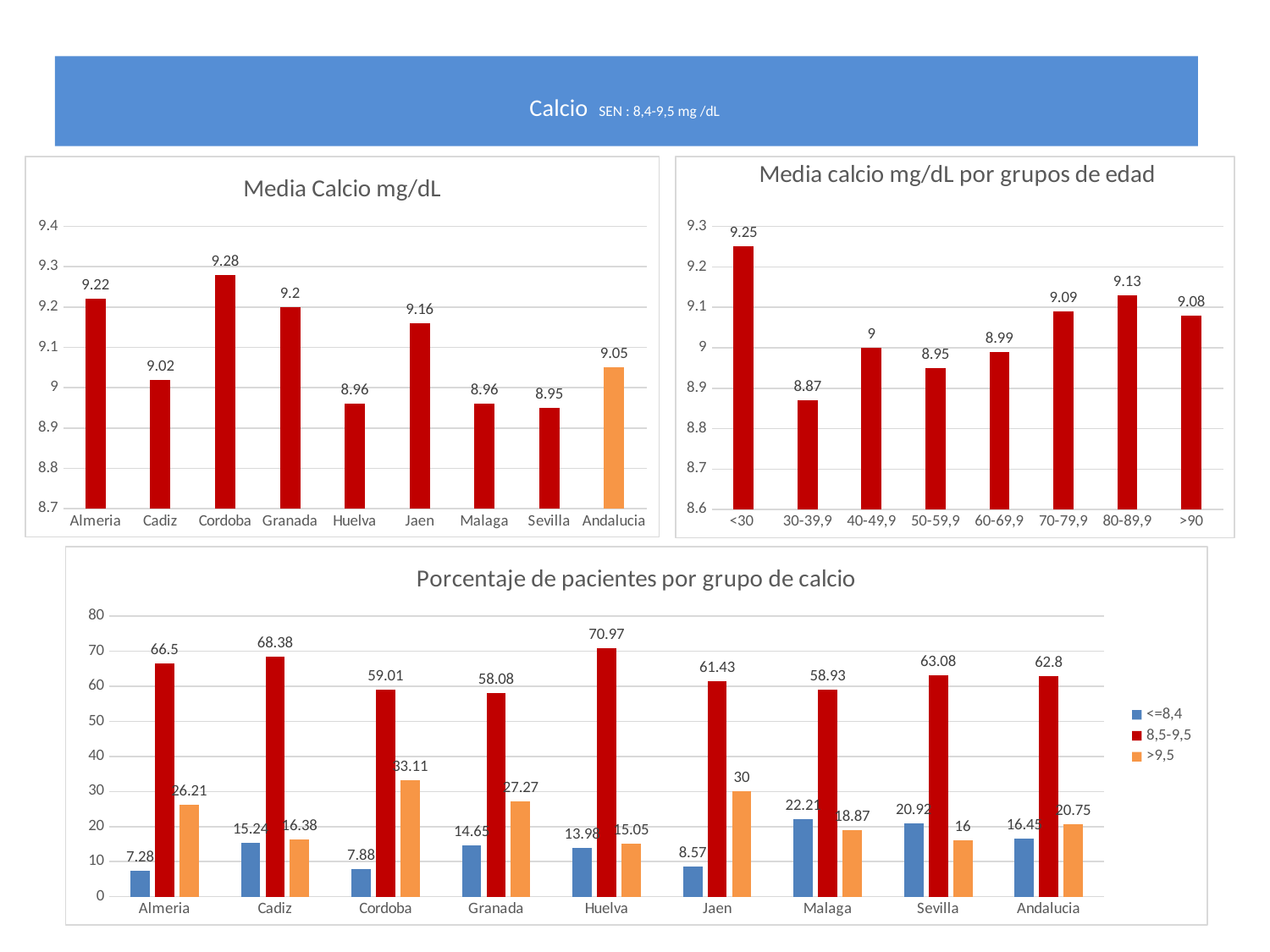
In the 'Media calcio mg/dL por grupos de edad' chart, what is the difference between the <30 group and the 30-39,9 group? 0.38 What kind of chart is 'Porcentaje de pacientes por grupo de calcio'? bar chart In the 'Porcentaje de pacientes por grupo de calcio' chart, which province has the highest value in the >9,5 series? Cordoba In the 'Media calcio mg/dL por grupos de edad' chart, which is larger, the value for 30-39,9 or for 50-59,9? 50-59,9 In the 'Media Calcio mg/dL' chart, what is the value for Cordoba? 9.28 In the 'Media Calcio mg/dL' chart, how many categories are shown on the x axis? 9 In the 'Media Calcio mg/dL' chart, what is the difference between Cordoba and Cadiz? 0.26 In the 'Media Calcio mg/dL' chart, which province has the lowest value? Sevilla In the 'Media calcio mg/dL por grupos de edad' chart, which age group has the highest value? <30 In the 'Porcentaje de pacientes por grupo de calcio' chart, how many series does the legend list? 3 In the 'Porcentaje de pacientes por grupo de calcio' chart, what is the value of the 8,5-9,5 series for Huelva? 70.97 In the 'Media calcio mg/dL por grupos de edad' chart, what is the value for the 80-89,9 group? 9.13